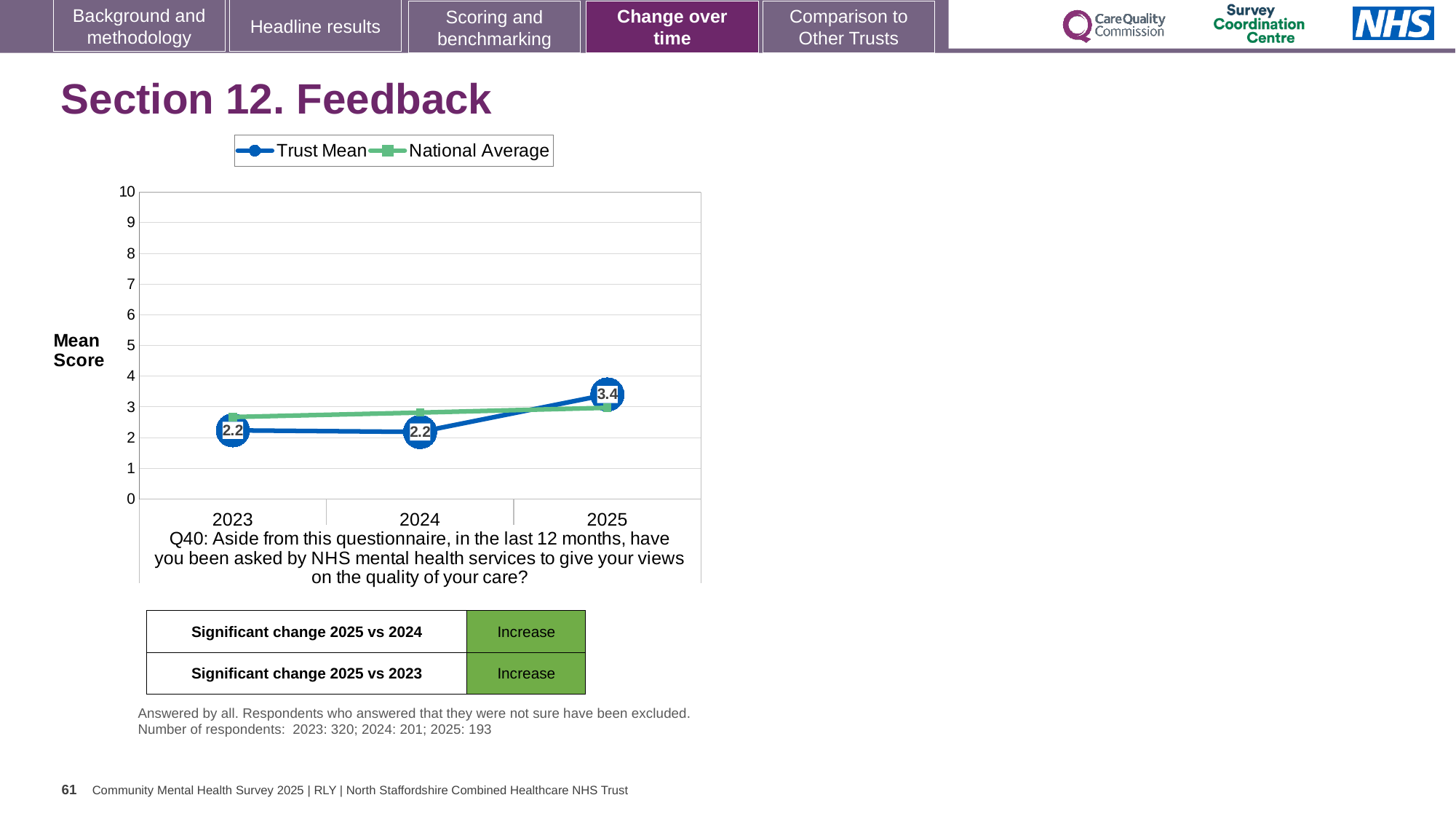
How many series does the legend list? 2 In which year is the Trust Mean highest? 2025 Is the National Average value for 2023 greater or less than 3? less What kind of chart is shown on the slide? line chart In 2023, which is larger: the Trust Mean or the National Average? National Average What is the Trust Mean score for 2025? 3.4 What is the Trust Mean score for 2024? 2.2 What is the difference between the Trust Mean in 2025 and in 2023? 1.2 How many years are shown on the x axis? 3 What is the Trust Mean score for 2023? 2.2 Does the Trust Mean rise or fall from 2024 to 2025? rise In 2025, which is larger: the Trust Mean or the National Average? Trust Mean